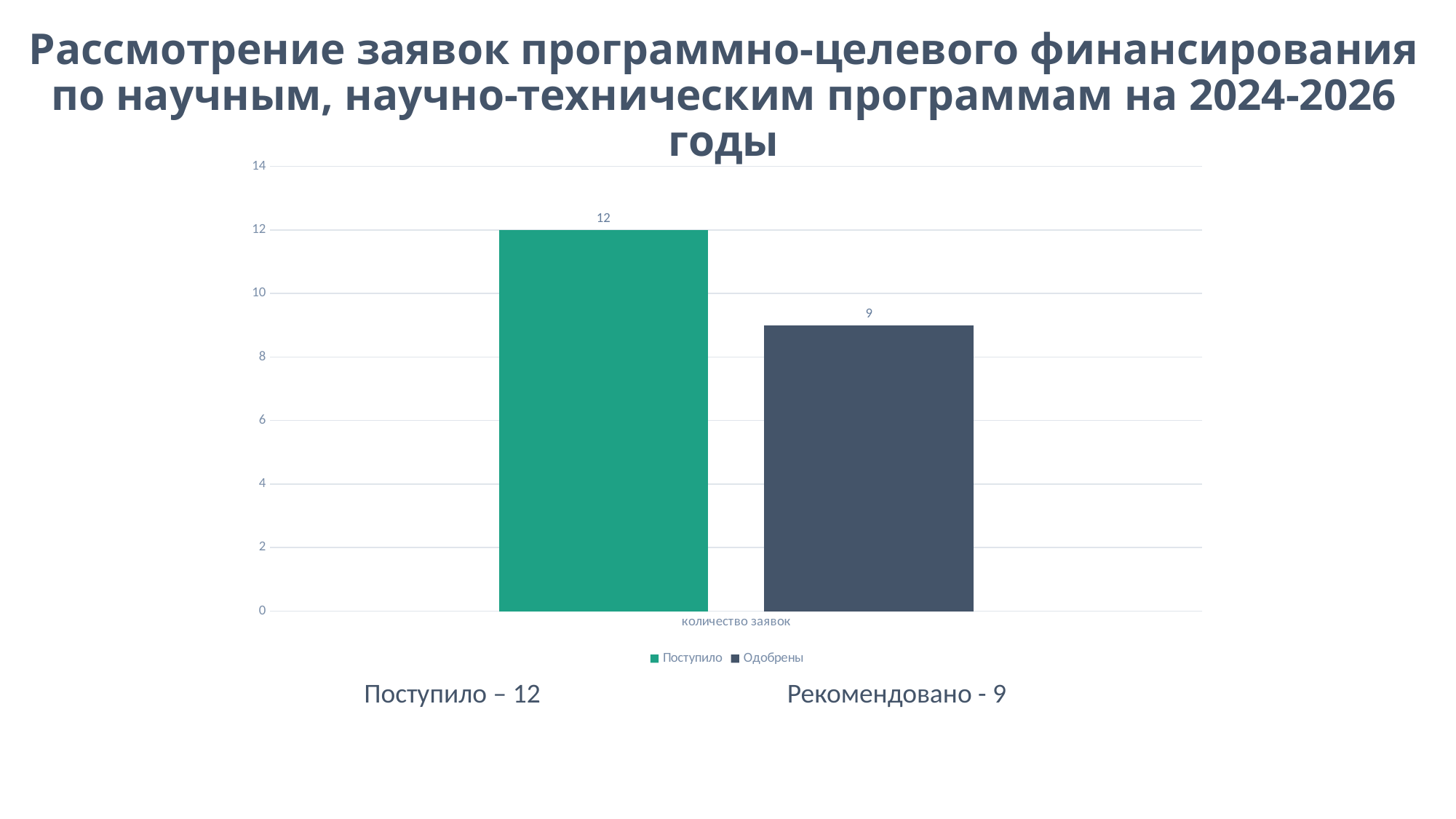
Which series has the higher value, "Поступило" or "Одобрены"? Поступило What is the maximum value shown on the y axis? 14 What is the value for the series "Поступило"? 12 How many series does the legend list? 2 What kind of chart is shown on the slide? bar chart What is the difference between the values for "Поступило" and "Одобрены"? 3 What colour is the bar for "Поступило"? green What is the category label shown on the x axis? количество заявок What is the value for the series "Одобрены"? 9 Is the value for "Одобрены" greater or less than 10? less Which series has the lowest value? Одобрены Is the value for "Поступило" greater or less than 10? greater